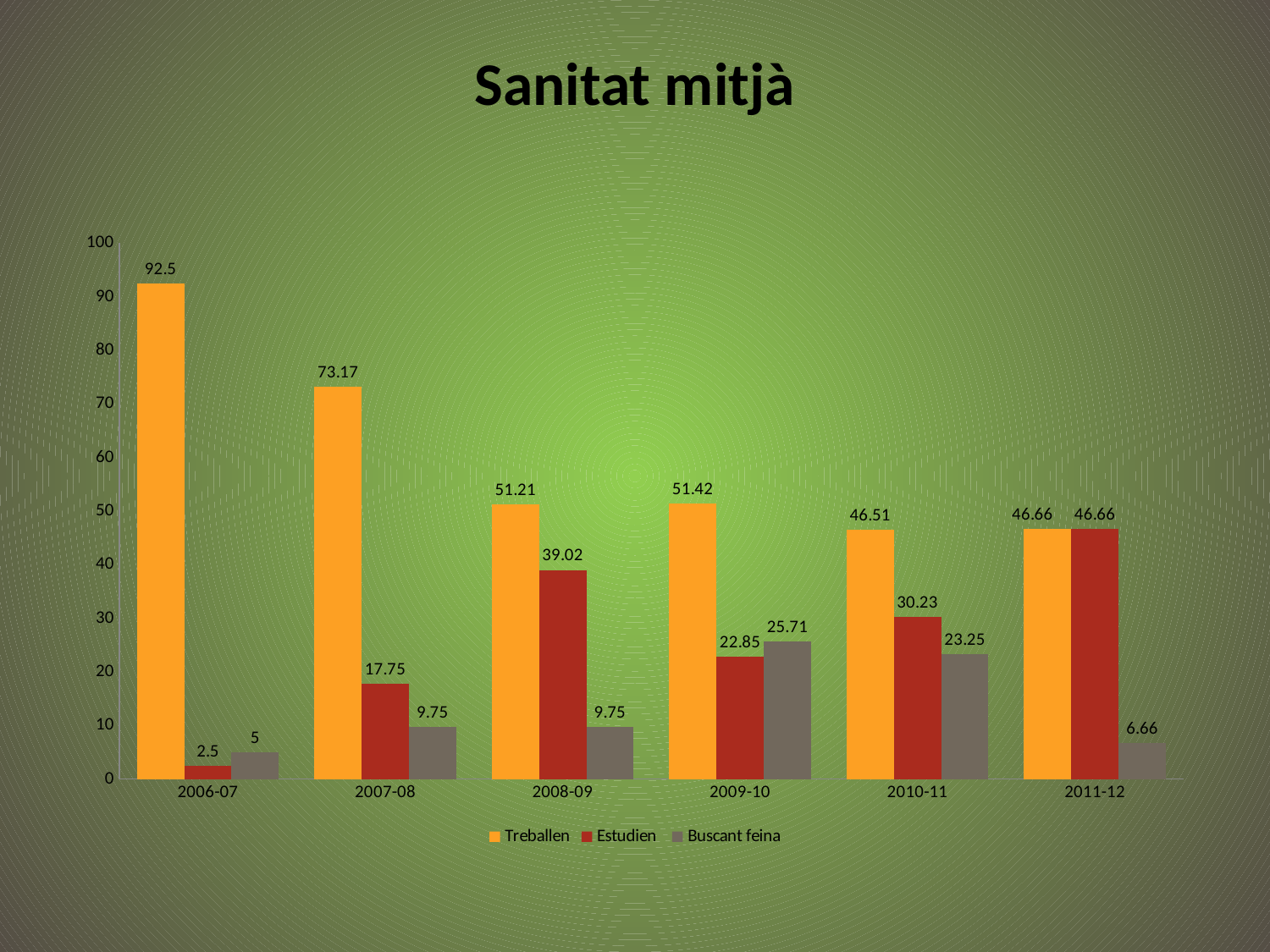
What is the value for Buscant feina in 2009-10? 25.71 How many series does the legend list? 3 How many years are shown on the x axis? 6 In which year is the Treballen value highest? 2006-07 Is the value for Treballen in 2007-08 greater or less than 70? greater What is the difference between the Treballen values for 2006-07 and 2007-08? 19.33 What is the value for Estudien in 2008-09? 39.02 Which is larger in 2010-11, Estudien or Buscant feina? Estudien What is the value for Treballen in 2006-07? 92.5 What kind of chart is shown on the slide? Bar chart Does the Treballen series generally rise or fall from 2006-07 to 2011-12? Fall In which year is the Estudien value lowest? 2006-07